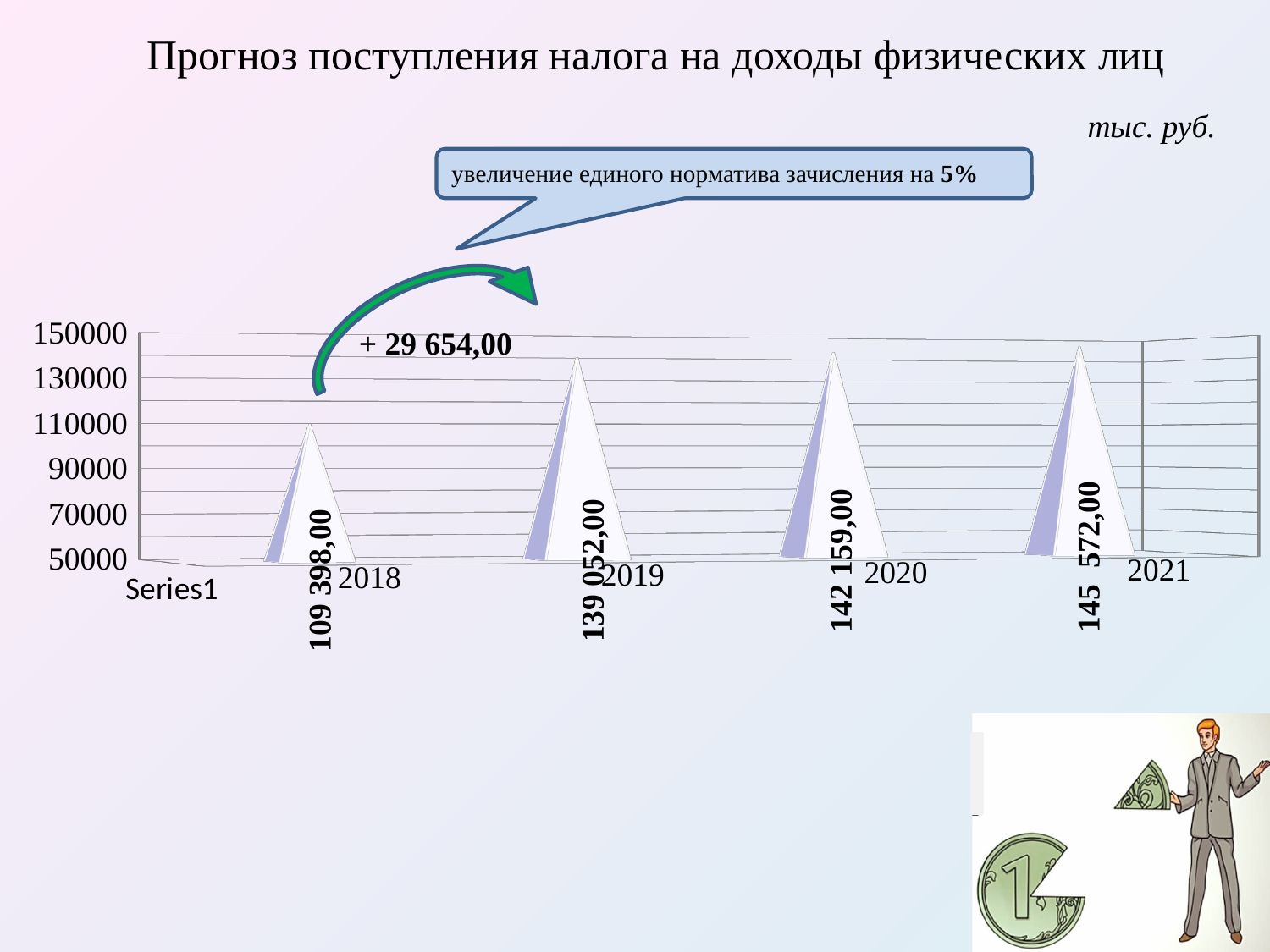
How many years are shown on the x axis? 4 Which year has the highest value? 2021 Which year has the lowest value? 2018 What is the value for 2018? 109 398,00 Do the values rise or fall from 2018 to 2021? rise What is the title of the chart? Прогноз поступления налога на доходы физических лиц What is the value for 2020? 142 159,00 What is the difference between the values for 2019 and 2018? 29 654,00 Is the value for 2018 greater or less than 130000? less Which is larger, the value for 2018 or the value for 2019? 2019 What is the value for 2021? 145 572,00 What is the value for 2019? 139 052,00